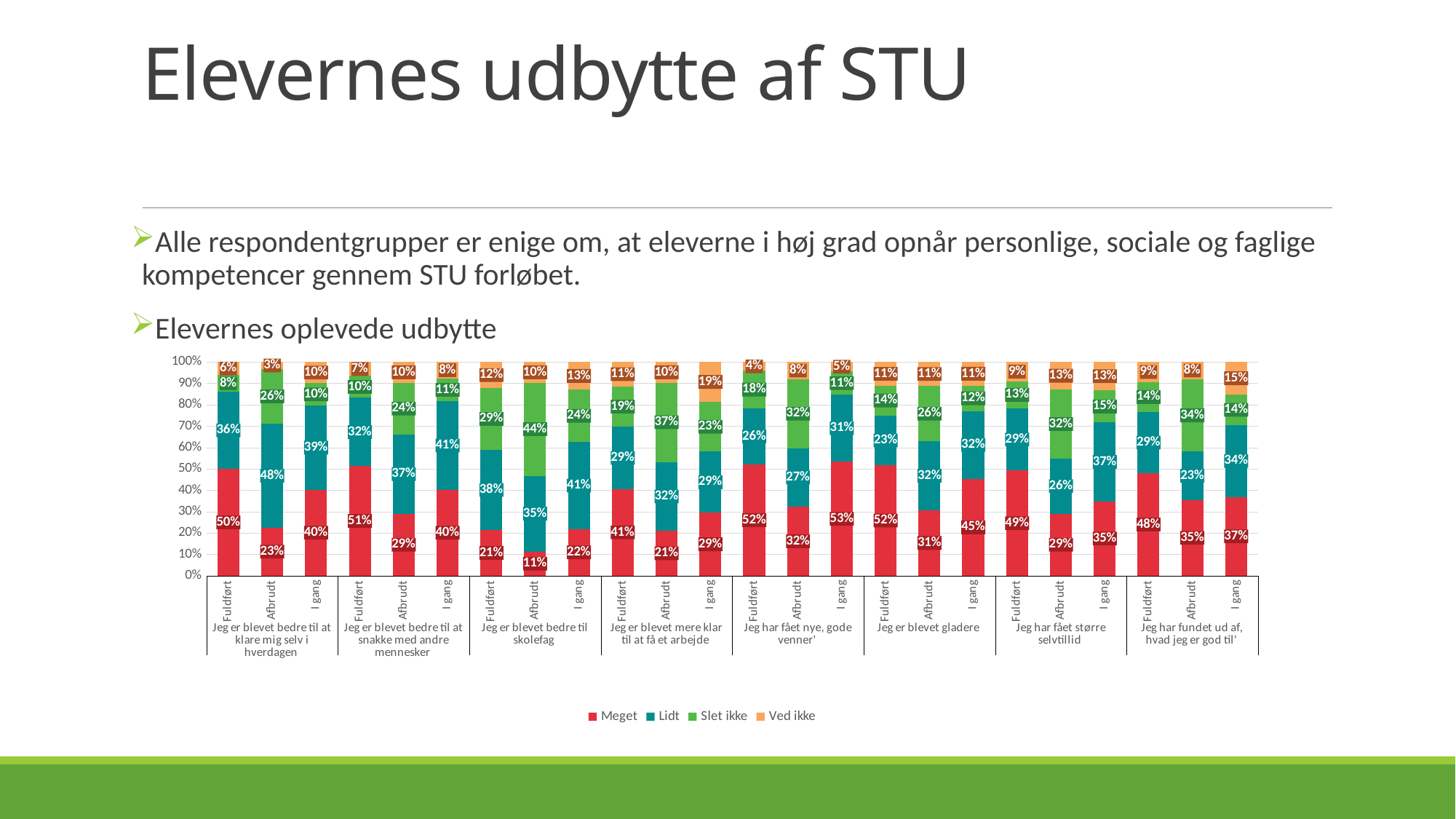
How many series does the chart legend list? 4 What is the 'Slet ikke' value for Afbrudt under 'Jeg er blevet bedre til skolefag'? 44% Which bar has the lowest 'Meget' value across the whole chart? Afbrudt, Jeg er blevet bedre til skolefag (11%) What type of chart is shown on the slide? Stacked bar chart What is the 'Lidt' value for Afbrudt under 'Jeg er blevet bedre til at klare mig selv i hverdagen'? 48% Under 'Jeg har fået større selvtillid', which is larger: the 'Meget' value for Fuldført or for I gang? Fuldført What is the 'Meget' value for Fuldført under 'Jeg er blevet bedre til at klare mig selv i hverdagen'? 50% What is the difference between the 'Meget' values for Fuldført and Afbrudt under 'Jeg er blevet gladere'? 21 percentage points How many statement groups are shown along the x axis? 8 What is the 'Ved ikke' value for I gang under 'Jeg er blevet mere klar til at få et arbejde'? 19% Which bar has the highest 'Meget' value across the whole chart? I gang, Jeg har fået nye, gode venner' (53%) Which colour represents the 'Ved ikke' series in the chart? Orange